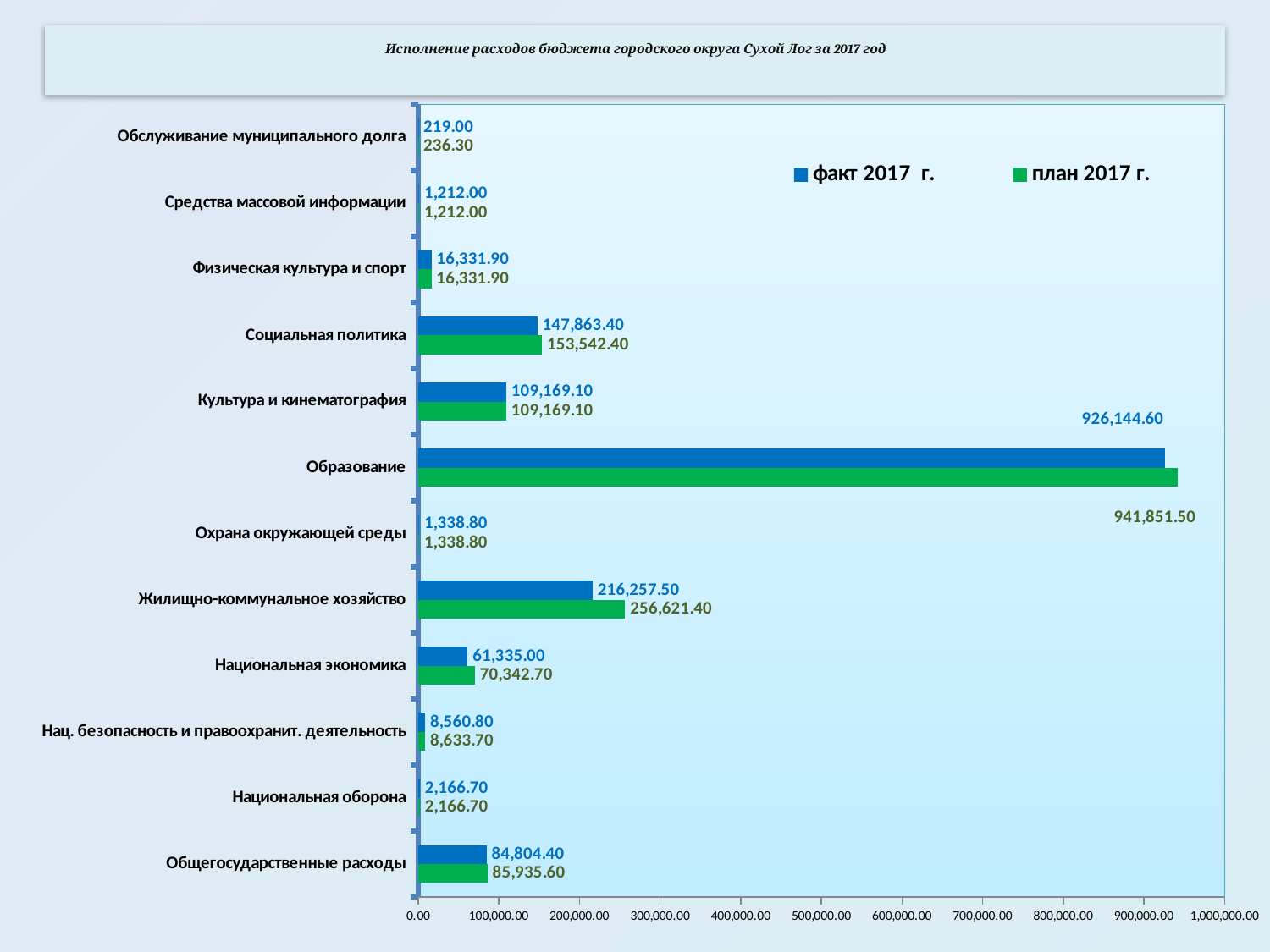
Which category has the highest план 2017 г. value? Образование What is the difference between the план 2017 г. and факт 2017 г. values for Жилищно-коммунальное хозяйство? 40,363.90 What is the факт 2017 г. value for Образование? 926,144.60 Which category has the lowest факт 2017 г. value? Обслуживание муниципального долга What is the difference between the план 2017 г. and факт 2017 г. values for Образование? 15,706.90 How many categories are shown on the chart? 12 What is the план 2017 г. value for Жилищно-коммунальное хозяйство? 256,621.40 What is the факт 2017 г. value for Социальная политика? 147,863.40 What is the план 2017 г. value for Обслуживание муниципального долга? 236.30 Which is larger for Национальная экономика: the факт 2017 г. value or the план 2017 г. value? план 2017 г. What kind of chart is shown on the slide? Bar chart How many series does the legend list? 2